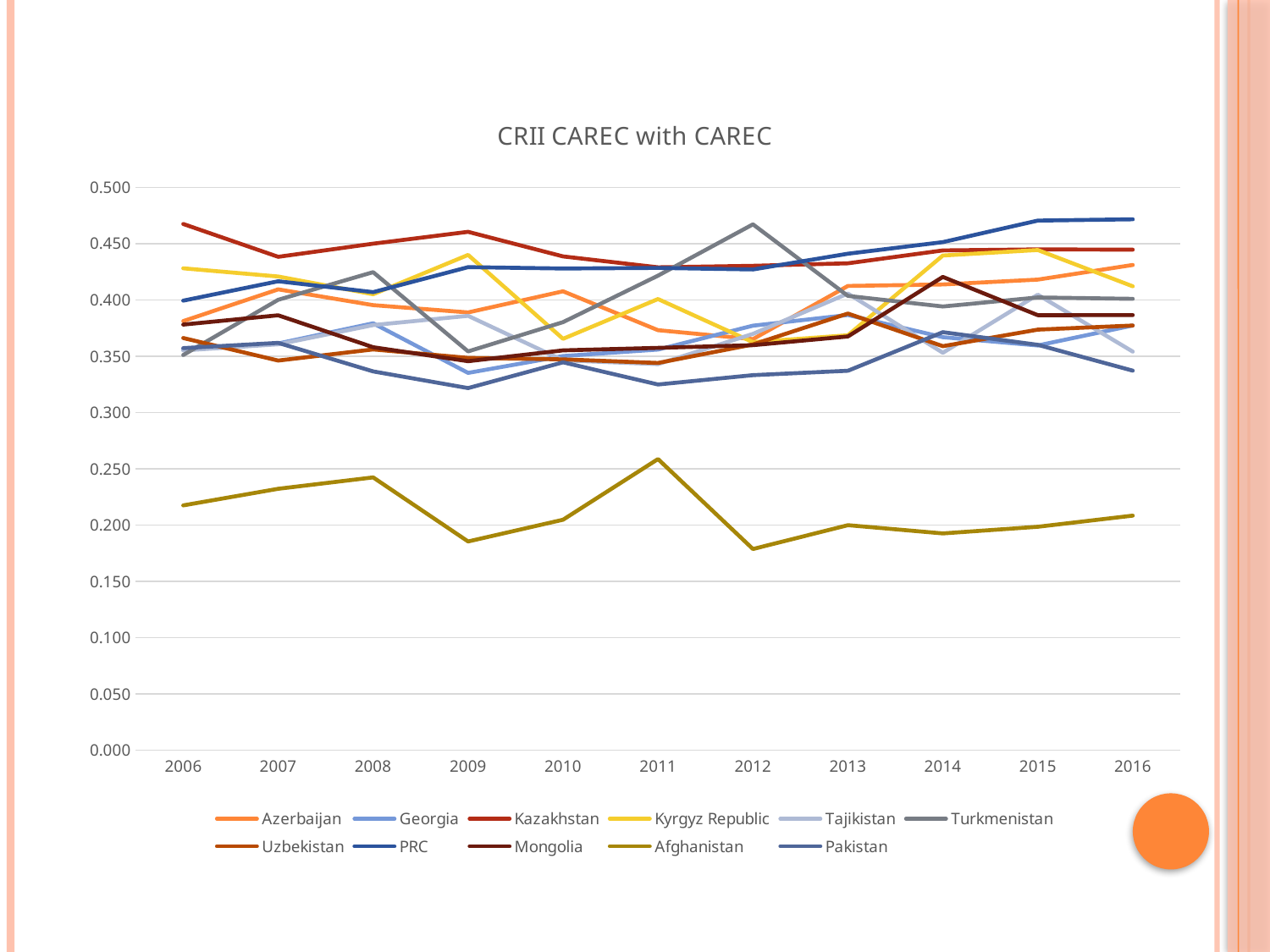
Which series has the highest value in 2016? PRC How many series does the legend list? 11 Which series has the highest value in 2006? Kazakhstan Is the value for Kazakhstan in 2006 greater or less than 0.450? greater What is the title of the chart? CRII CAREC with CAREC What kind of chart is shown on the slide? line chart Is the value for Afghanistan in 2012 greater or less than 0.200? less Is the value for Afghanistan in 2011 greater or less than 0.250? greater Which series has the lowest values across the whole chart? Afghanistan How many years are shown on the x axis? 11 Does the PRC line rise or fall from 2012 to 2016? rise